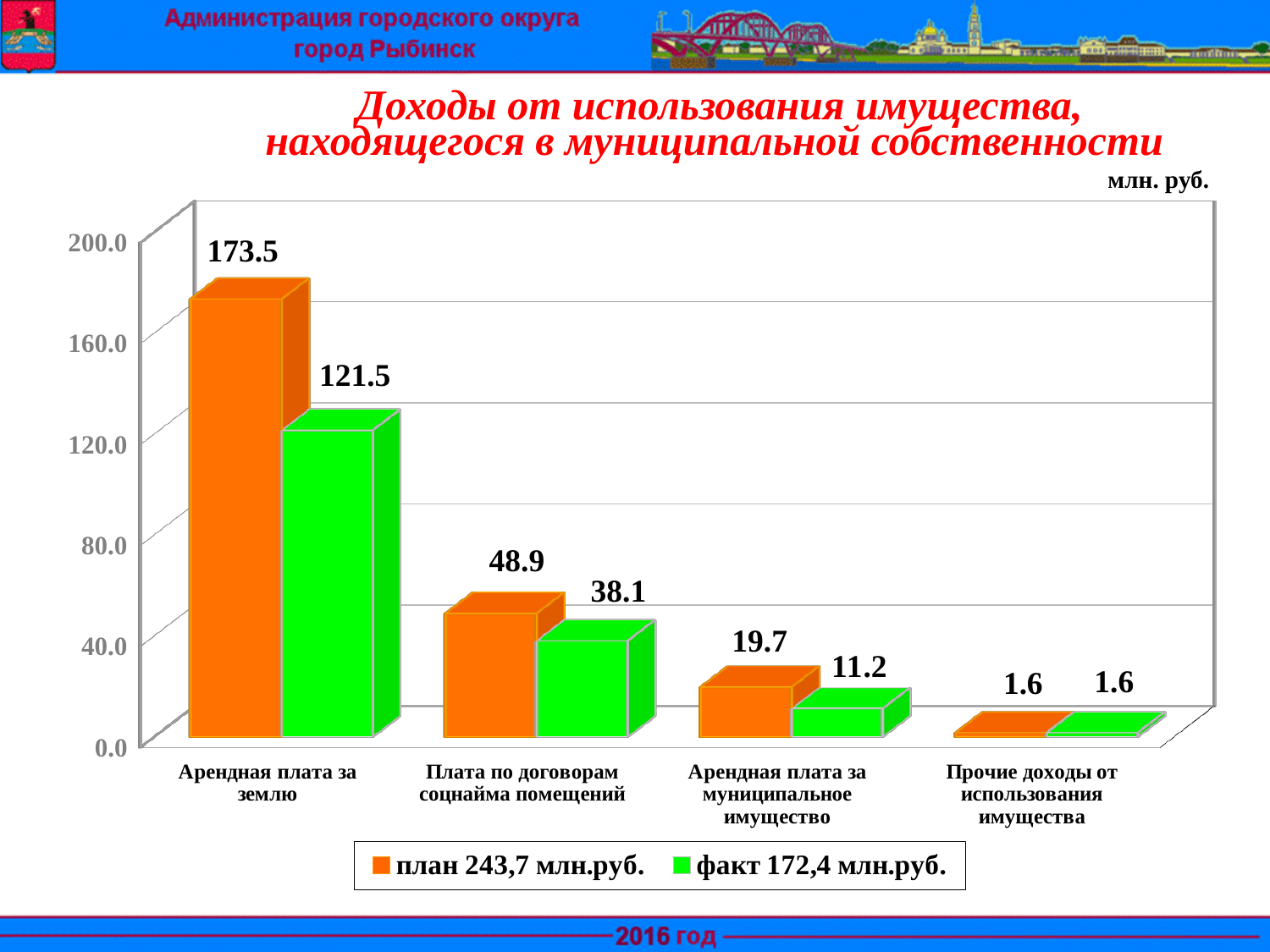
How many series does the legend list? 2 What is the actual value (факт) for Арендная плата за муниципальное имущество? 11.2 How many categories are shown on the x axis? 4 Which is larger for Арендная плата за муниципальное имущество: the planned value or the actual value? план (19.7) What is the actual value (факт) for Плата по договорам соцнайма помещений? 38.1 What is the difference between the planned and actual values for Арендная плата за землю? 52.0 Which category has the highest planned value (план)? Арендная плата за землю What is the difference between the planned and actual values for Плата по договорам соцнайма помещений? 10.8 What kind of chart is shown on the slide? Bar chart What total planned amount is stated in the legend? 243,7 млн.руб. What is the planned value (план) for Арендная плата за землю? 173.5 Which category has the lowest actual value (факт)? Прочие доходы от использования имущества